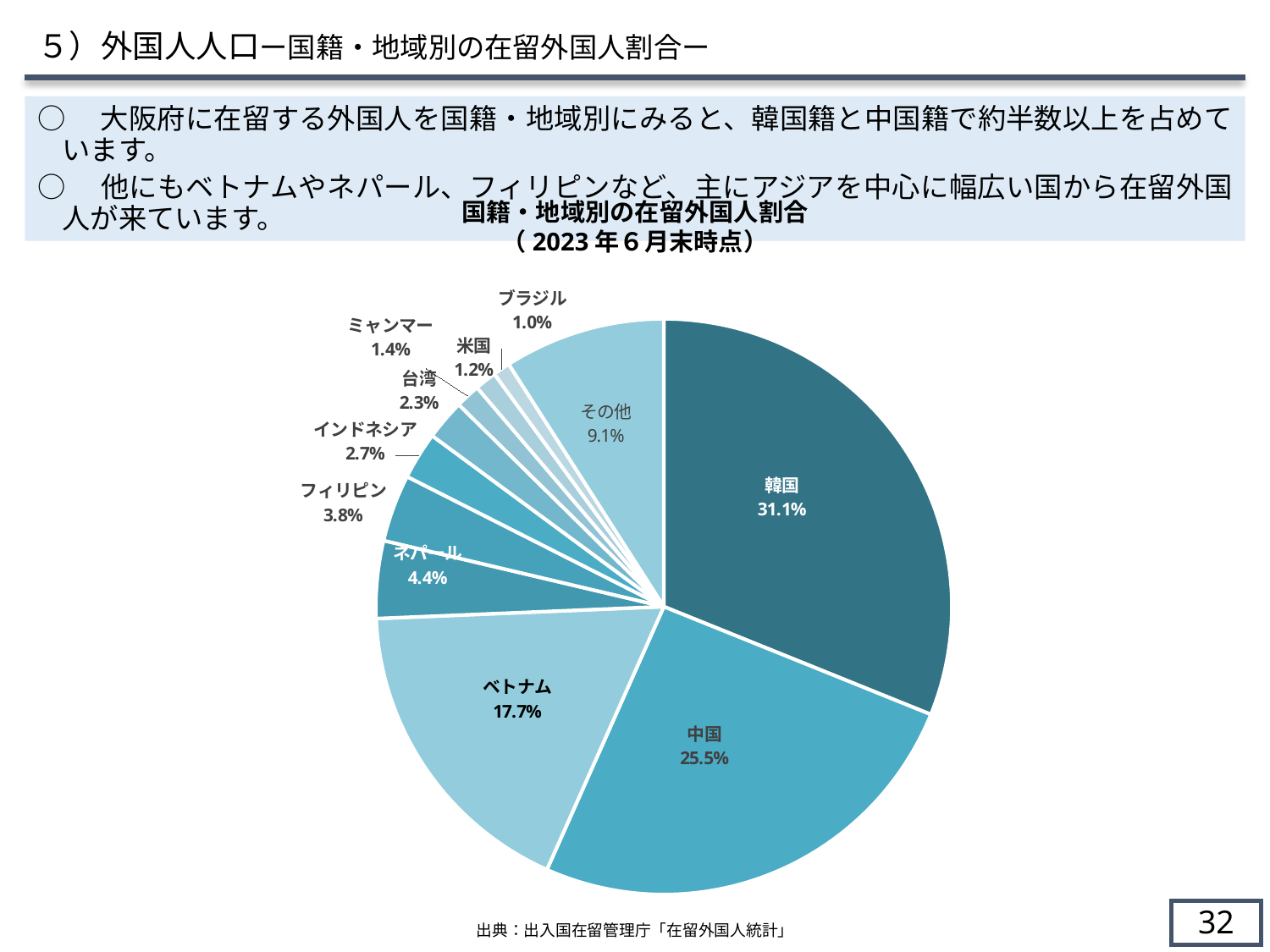
What is the share for その他 (Other)? 9.1% What is the title of the chart? 国籍・地域別の在留外国人割合（2023年6月末時点） What share of the pie does 韓国 (Korea) account for? 31.1% How many slices does the pie chart have? 11 Which nationality/region has the largest share in the pie chart? 韓国 Which labelled nationality/region has the smallest share in the pie chart? ブラジル What is the combined share of 韓国 and 中国? 56.6% What type of chart is shown on the slide? Pie chart What is the value shown for ベトナム (Vietnam)? 17.7% Which is larger, the share for フィリピン or the share for インドネシア? フィリピン What percentage is shown for ネパール (Nepal)? 4.4% What is the difference in percentage points between 韓国 and 中国? 5.6